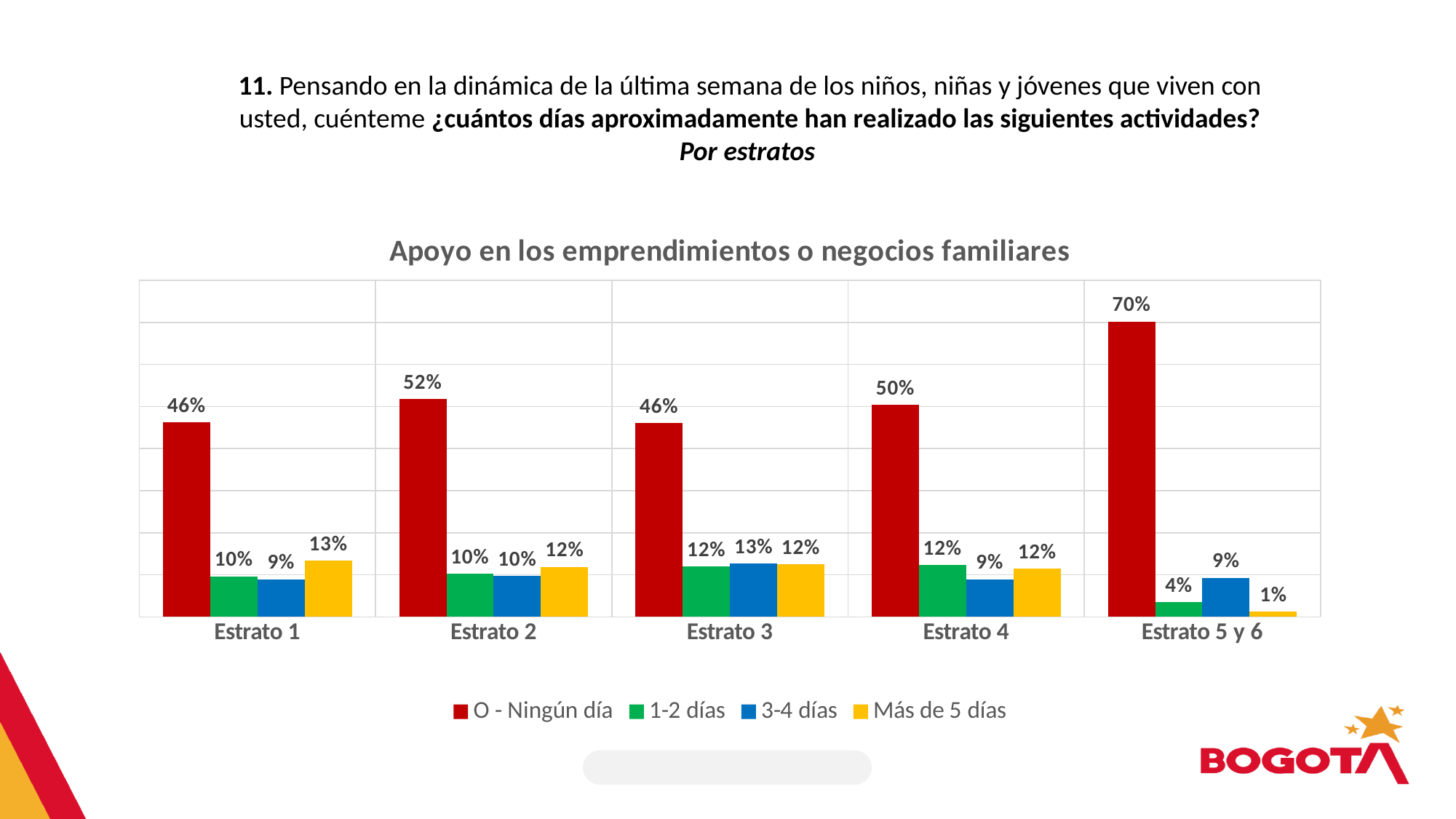
How many estrato categories are shown on the x axis? 5 What is the title of the chart? Apoyo en los emprendimientos o negocios familiares Which is larger: "O - Ningún día" in Estrato 2 or in Estrato 4? Estrato 2 How many series does the legend list? 4 What is the value for "3-4 días" in Estrato 3? 13% What is the difference between the "O - Ningún día" values for Estrato 5 y 6 and Estrato 1? 24% Which estrato has the lowest value for "Más de 5 días"? Estrato 5 y 6 Which estrato has the highest value for "O - Ningún día"? Estrato 5 y 6 What is the value for "Más de 5 días" in Estrato 1? 13% What kind of chart is shown on the slide? Bar chart What is the value for "1-2 días" in Estrato 5 y 6? 4% What is the value for "O - Ningún día" in Estrato 5 y 6? 70%